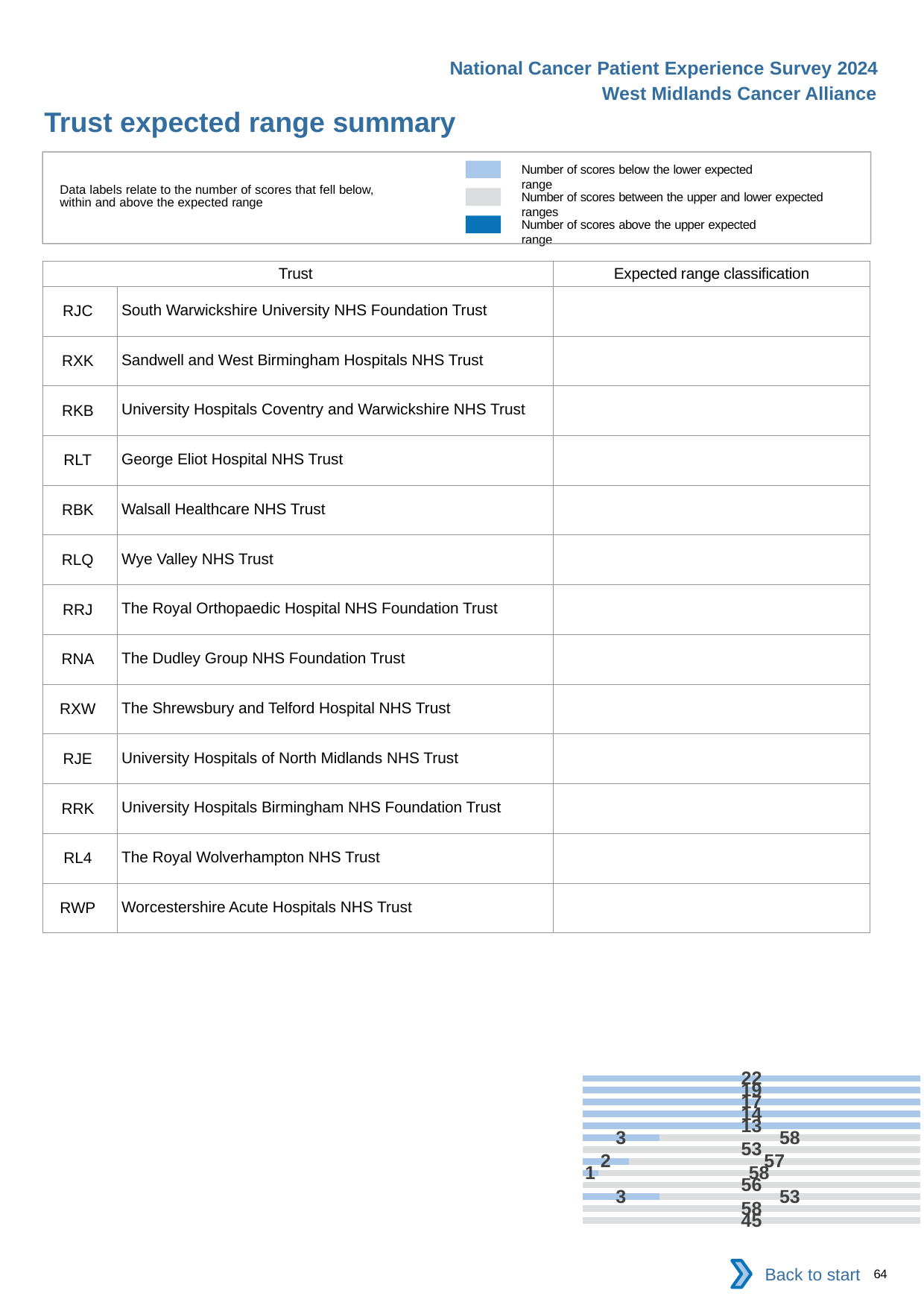
What is the largest data label printed on the chart? 58 How many series does the legend for the chart list? 3 What is the smallest data label printed on the chart? 1 According to the legend, what does the light blue colour in the chart represent? Number of scores below the lower expected range What kind of chart is shown at the bottom right of the slide? bar chart According to the legend, what does the dark blue colour in the chart represent? Number of scores above the upper expected range